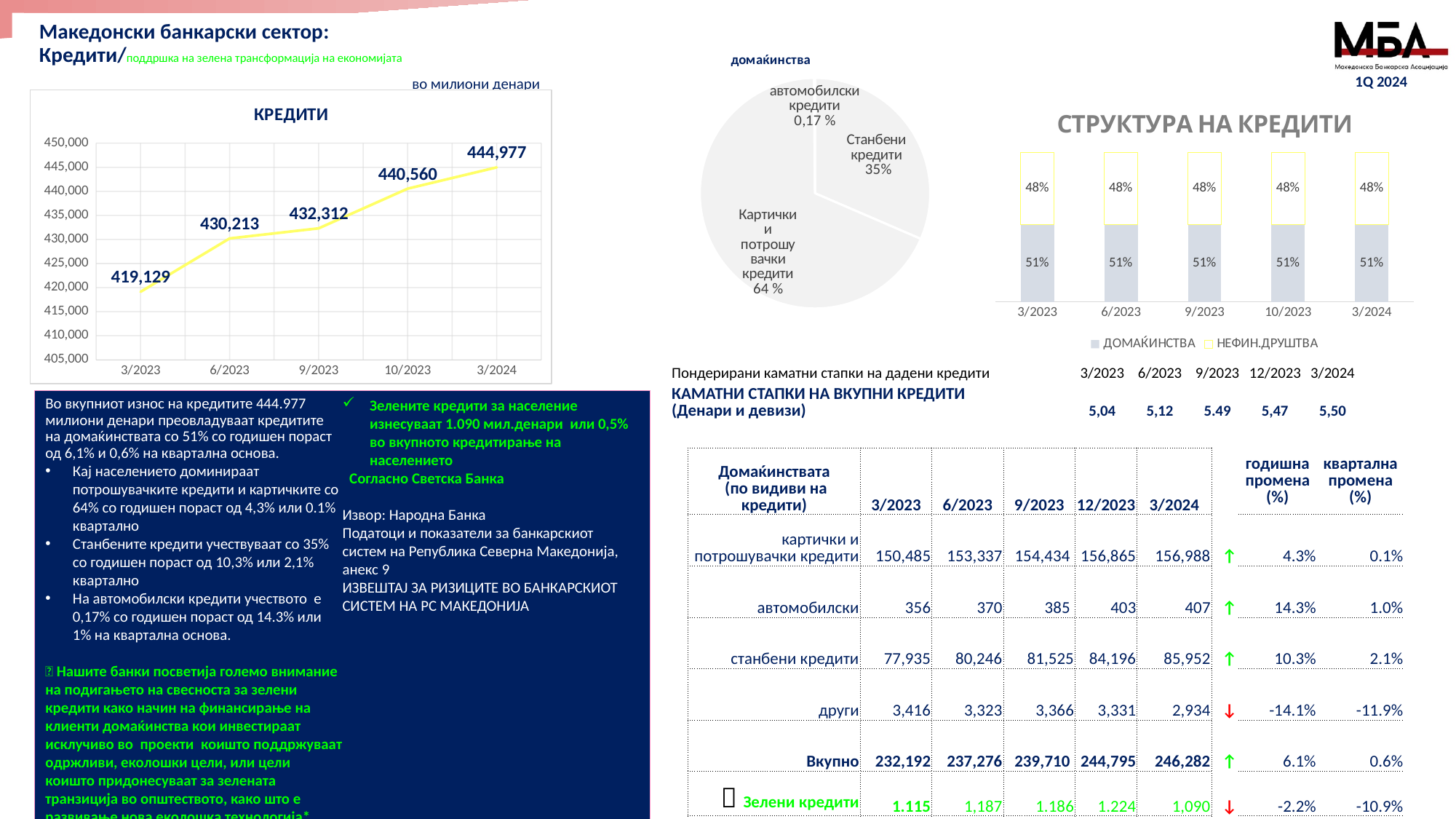
In the line chart titled КРЕДИТИ, what is the value for 3/2023? 419,129 What kind of chart is the chart titled КРЕДИТИ? line chart In the chart titled СТРУКТУРА НА КРЕДИТИ, what is the value for ДОМАЌИНСТВА in 3/2024? 51% In the line chart titled КРЕДИТИ, what is the difference between the values for 3/2024 and 10/2023? 4,417 In the line chart titled КРЕДИТИ, how many data points are plotted? 5 In the pie chart titled домаќинства, what share do Станбени кредити have? 35% In the line chart titled КРЕДИТИ, which period has the lowest value? 3/2023 In the line chart titled КРЕДИТИ, do the values rise or fall from 3/2023 to 3/2024? rise In the line chart titled КРЕДИТИ, what is the value for 3/2024? 444,977 In the pie chart titled домаќинства, which category has the largest slice? Картички и потрошувачки кредити How many series does the legend of the chart titled СТРУКТУРА НА КРЕДИТИ list? 2 In the pie chart titled домаќинства, what is the share of автомобилски кредити? 0,17 %